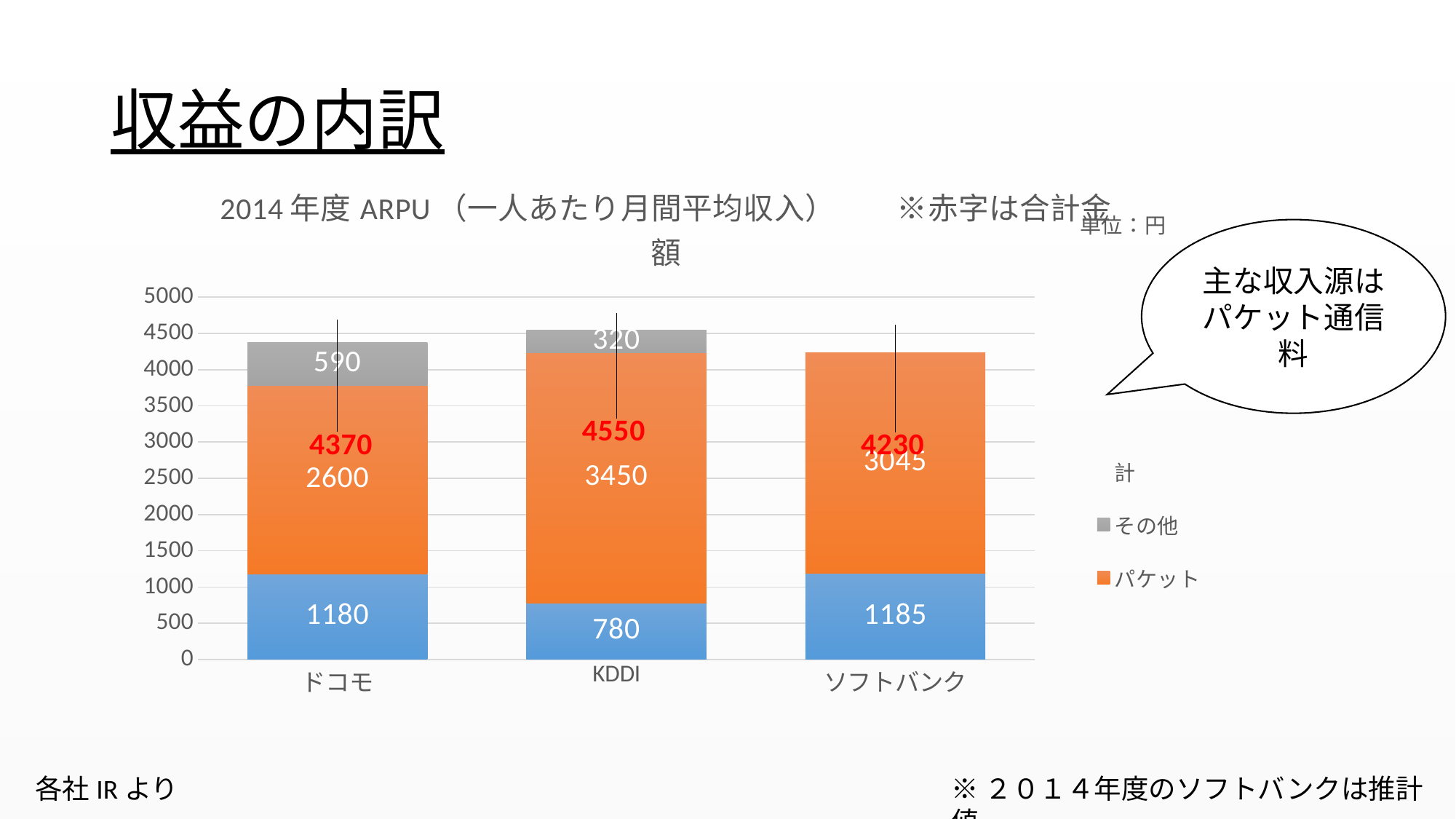
What kind of chart is shown on the slide? stacked bar chart Is the top of the ソフトバンク bar greater or less than 4000? greater How many companies are shown on the x axis? 3 What value is printed in the blue bottom segment of the ソフトバンク bar? 1185 Which has the larger その他 value, ドコモ or KDDI? ドコモ How many entries does the legend list? 3 What is the difference between the パケット values of KDDI and ドコモ? 850 What is the パケット value for KDDI? 3450 What is the その他 value for ドコモ? 590 Which company has the highest パケット value? KDDI What total (red label) is shown for ソフトバンク? 4230 Which company has the highest total (red label)? KDDI